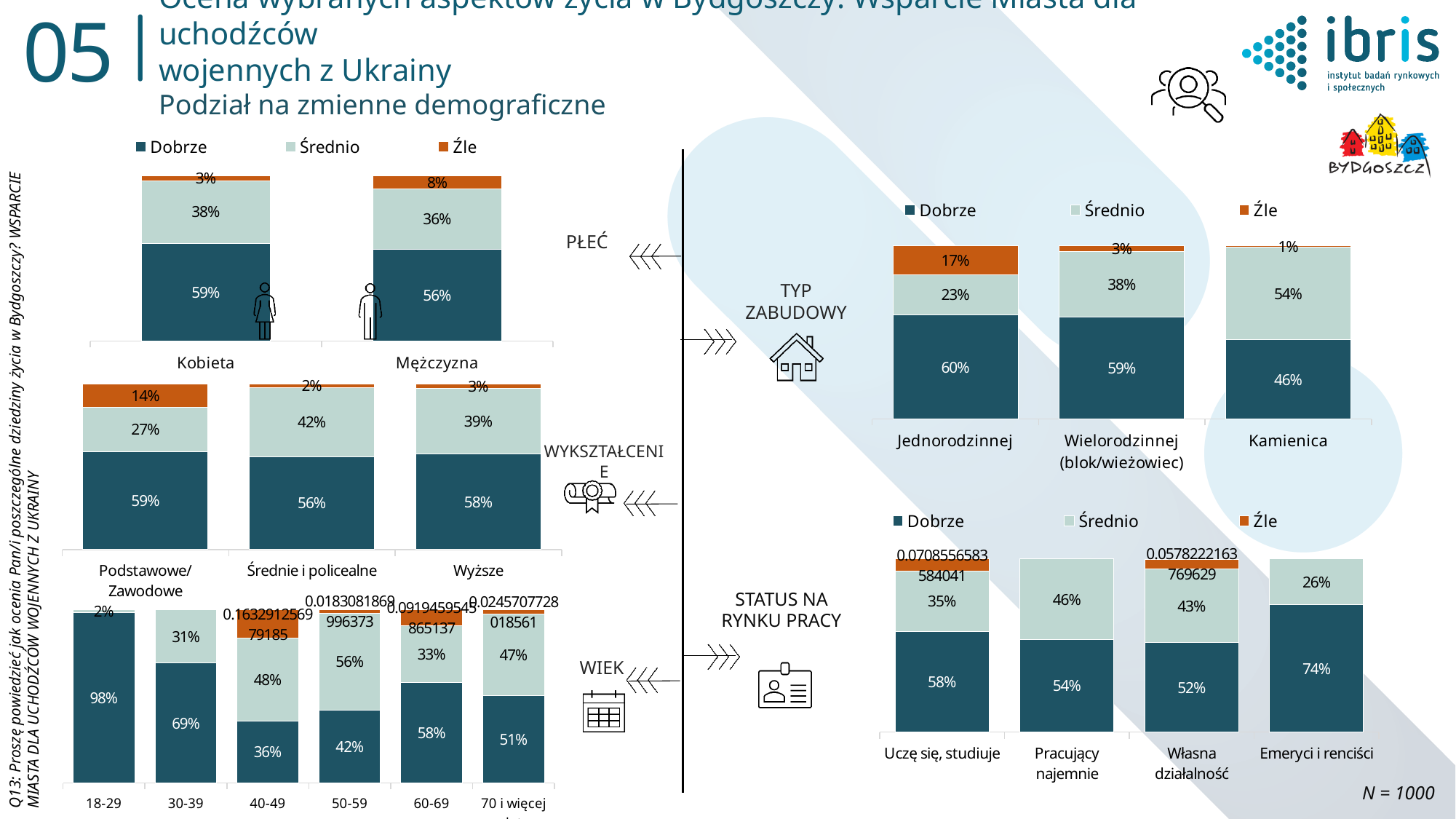
In the WYKSZTAŁCENIE chart, what is the Źle value for Podstawowe/Zawodowe? 14% In the STATUS NA RYNKU PRACY chart, which has a higher Dobrze share: Pracujący najemnie or Własna działalność? Pracujący najemnie In the TYP ZABUDOWY chart, what is the Średnio value for Kamienica? 54% In the WIEK chart, which age group has the lowest Dobrze share? 40-49 In the STATUS NA RYNKU PRACY chart, what is the Dobrze value for Emeryci i renciści? 74% In the PŁEĆ chart, what percentage of Kobieta answered Dobrze? 59% In the PŁEĆ chart, what percentage of Mężczyzna answered Źle? 8% In the TYP ZABUDOWY chart, what is the difference in Dobrze between Jednorodzinnej and Kamienica? 14 percentage points In the WIEK chart, what is the Dobrze value for the 18-29 age group? 98% In the WIEK chart, how many age groups are shown? 6 How many series does the legend of the TYP ZABUDOWY chart list? 3 In the WYKSZTAŁCENIE chart, which education group has the highest Średnio share? Średnie i policealne